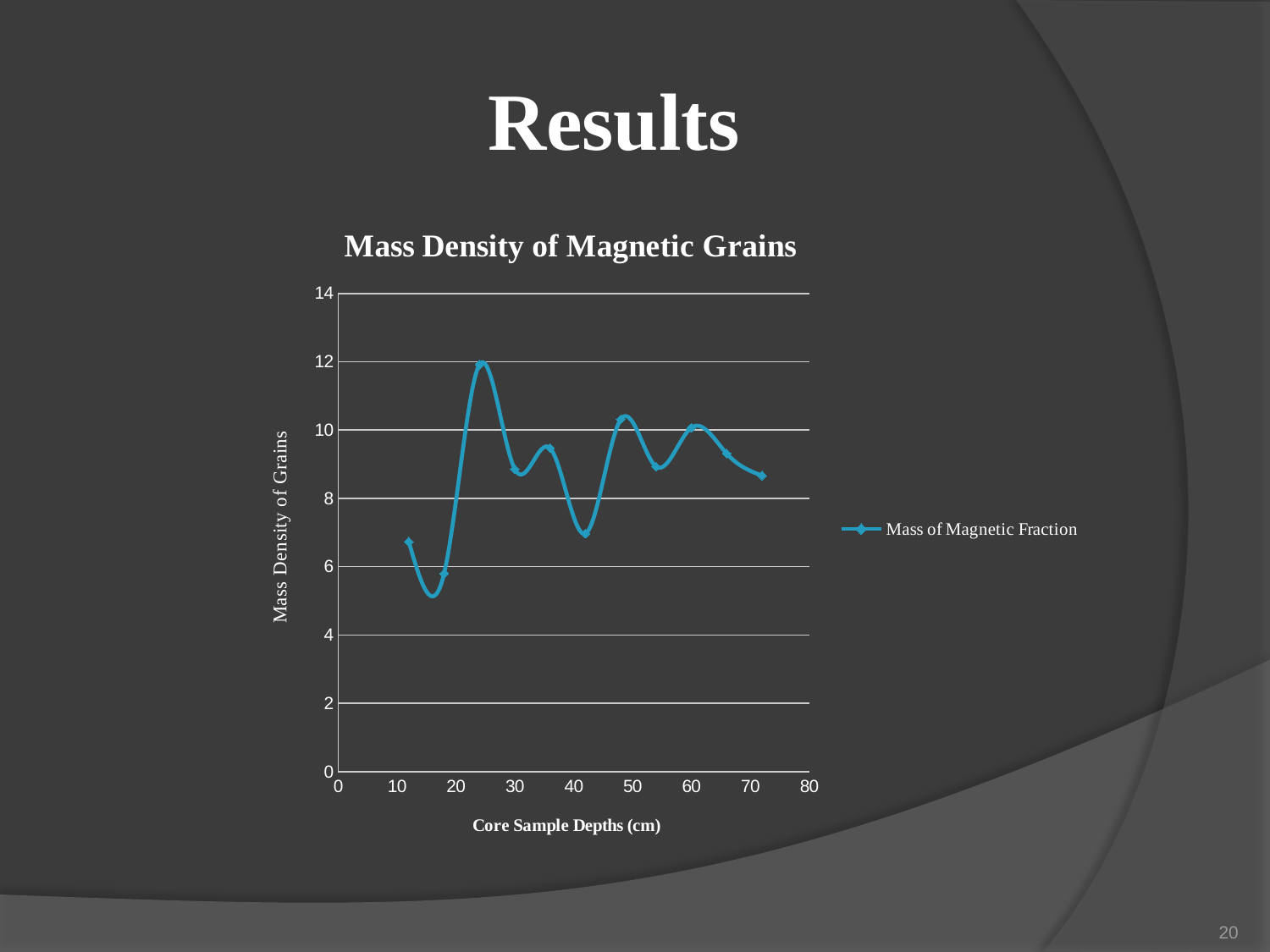
What is the name of the series shown in the legend? Mass of Magnetic Fraction How many series does the legend list? 1 Does the value rise or fall between the second and third plotted points? rise Is the lowest value on the line greater or less than 8? less Is the value of the first plotted point (at the shallowest depth) greater or less than 8? less What kind of chart is shown on the slide? line chart Is the highest value on the line greater or less than 10? greater Does the value rise or fall between the first and second plotted points? fall What is the title of the chart? Mass Density of Magnetic Grains How many data points are plotted on the line? 11 What is the highest tick value shown on the y axis? 14